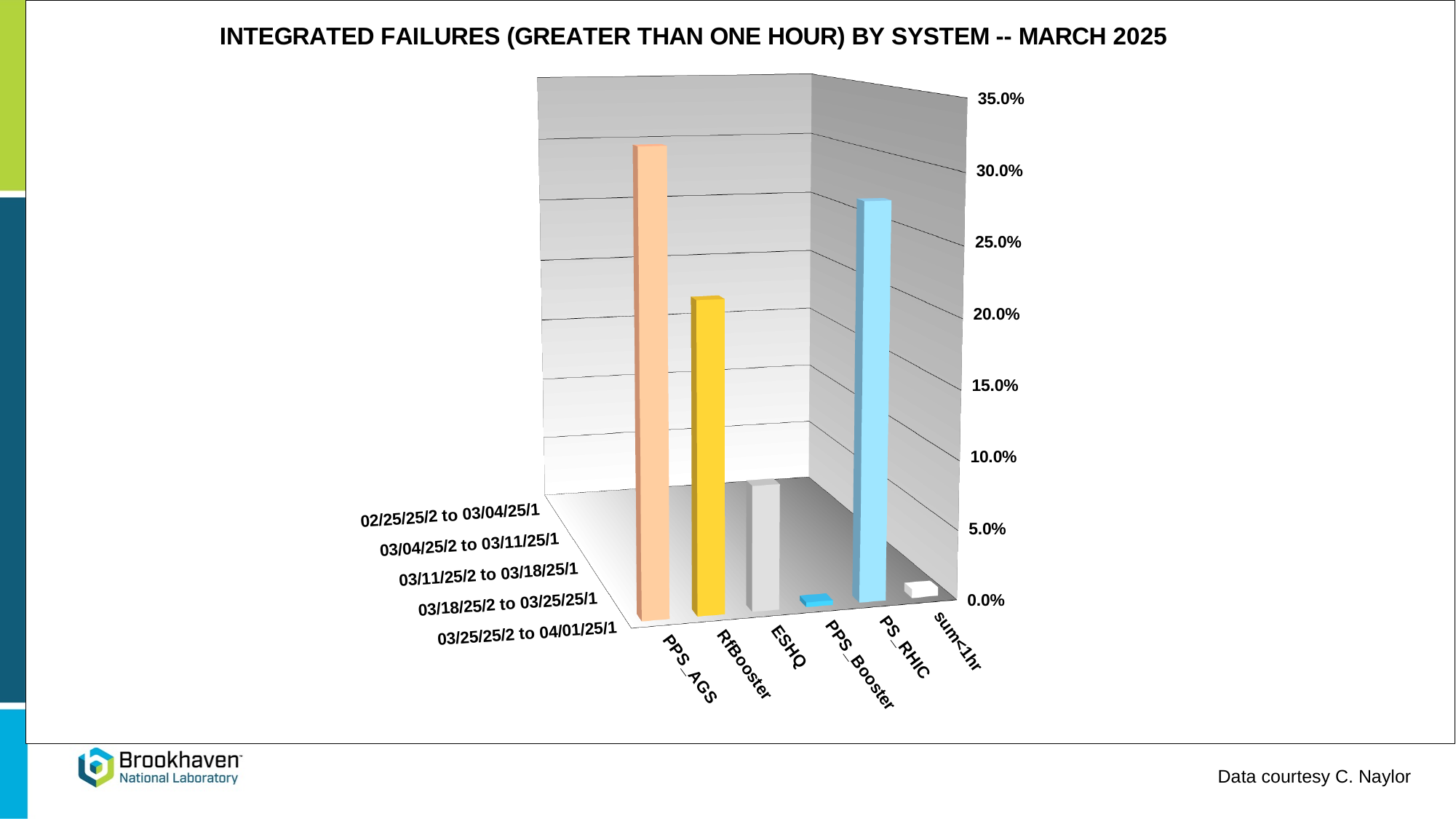
Which system has the tallest bar in the chart? PPS_AGS Is the value for ESHQ greater or less than 15.0%? less Is the value for PPS_AGS greater or less than 25.0%? greater Which is larger, the value for RfBooster or the value for ESHQ? RfBooster What kind of chart is shown on the slide? bar chart What is the highest value labelled on the vertical axis of the chart? 35.0% What is the title of the chart? INTEGRATED FAILURES (GREATER THAN ONE HOUR) BY SYSTEM -- MARCH 2025 Which is larger, the value for PPS_AGS or the value for PS_RHIC? PPS_AGS How many system categories are shown along the horizontal axis of the chart? 6 Is the value for PS_RHIC greater or less than 20.0%? greater